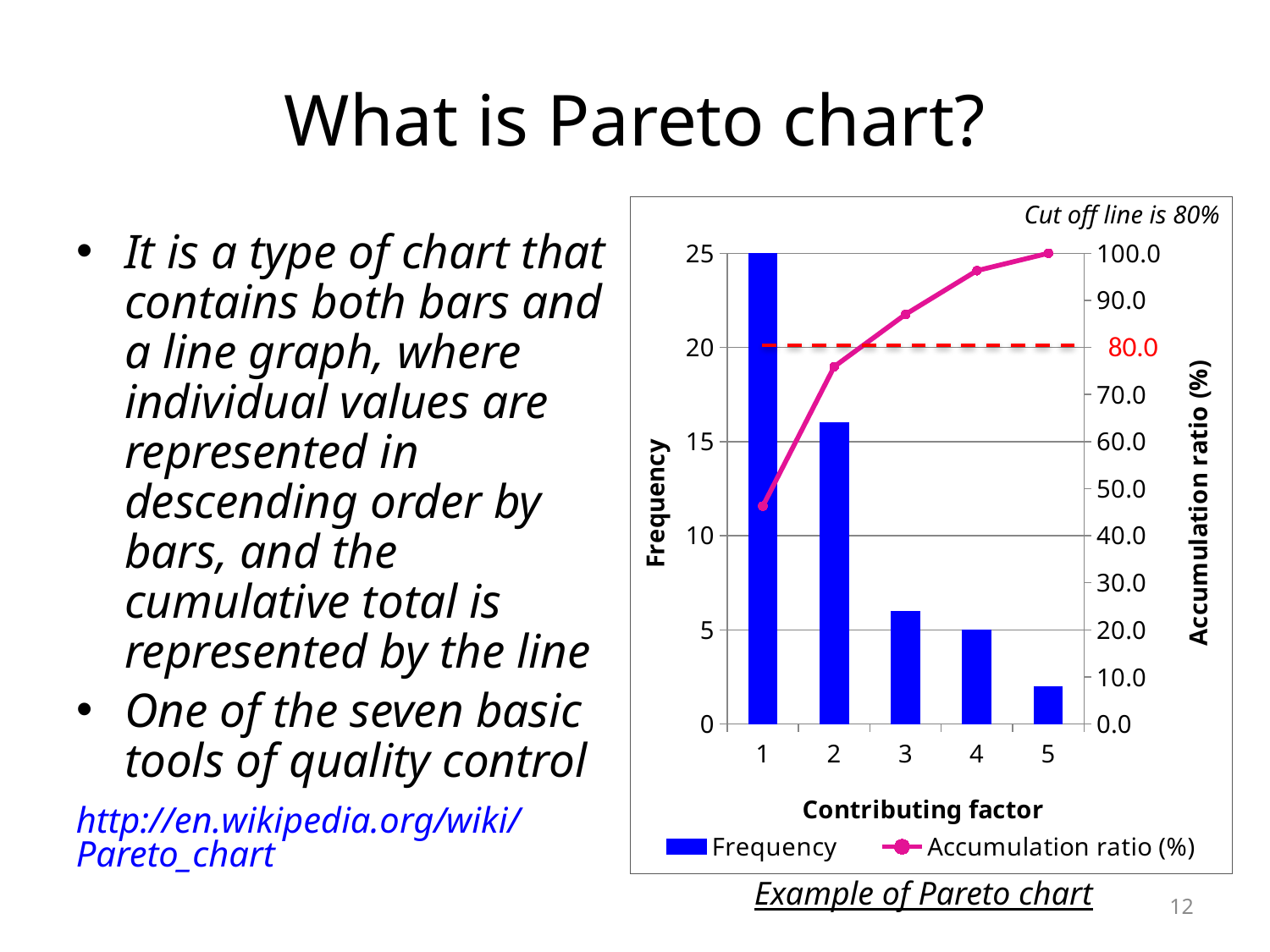
At what accumulation ratio is the cut off line drawn? 80% Do the frequency bars rise or fall from contributing factor 1 to 5? fall Is the accumulation ratio for contributing factor 1 greater or less than 50.0? less How many series does the legend list? 2 What is the frequency for contributing factor 1? 25 What kind of chart is shown on the slide? A combined bar and line chart (Pareto chart) Which has the larger frequency, contributing factor 2 or contributing factor 3? Contributing factor 2 Is the frequency for contributing factor 2 greater or less than 15? greater Which contributing factor has the highest frequency? 1 How many contributing factors are plotted on the x axis? 5 What is the frequency for contributing factor 4? 5 Which contributing factor has the lowest frequency? 5